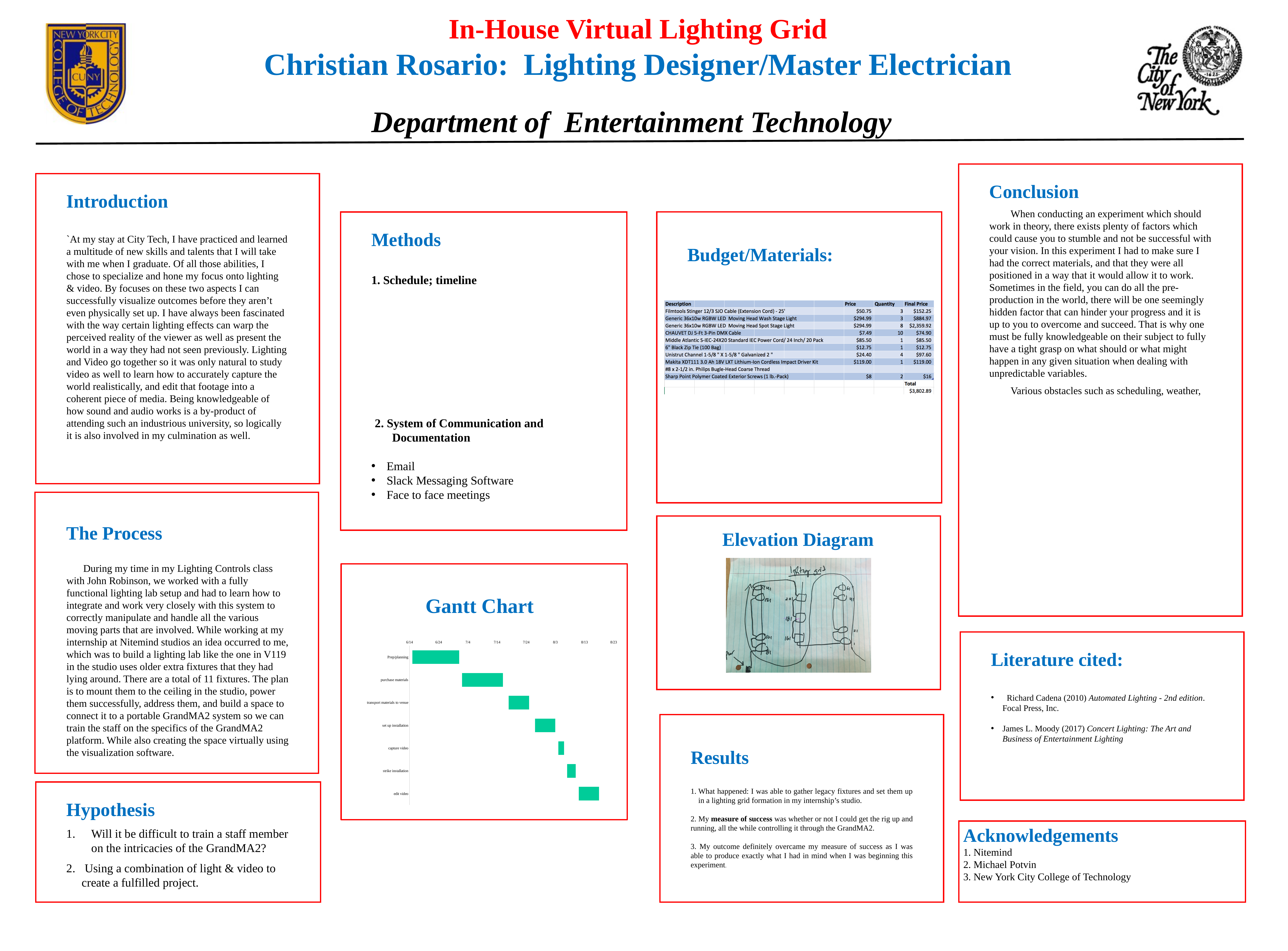
In the Gantt Chart, does the purchase materials bar end before or after 7/24? before In the Gantt Chart, which task has the shortest bar? capture video What kind of chart is the Gantt Chart on the slide? bar chart In the Gantt Chart, which task starts later: set up installation or transport materials to venue? set up installation How many tasks are listed on the y axis of the Gantt Chart? 7 In the Gantt Chart, which task is listed last (at the bottom)? edit video In the Gantt Chart, does the Prep/planning bar start before or after 7/4? before What is the title of the chart in the lower middle of the slide? Gantt Chart In the Gantt Chart, do the bars start progressively later or earlier as you move down the task list? later In the Gantt Chart, which task is listed first (at the top)? Prep/planning What is the first date tick shown on the x axis of the Gantt Chart? 6/14 In the Gantt Chart, does the edit video bar start before or after 8/3? after